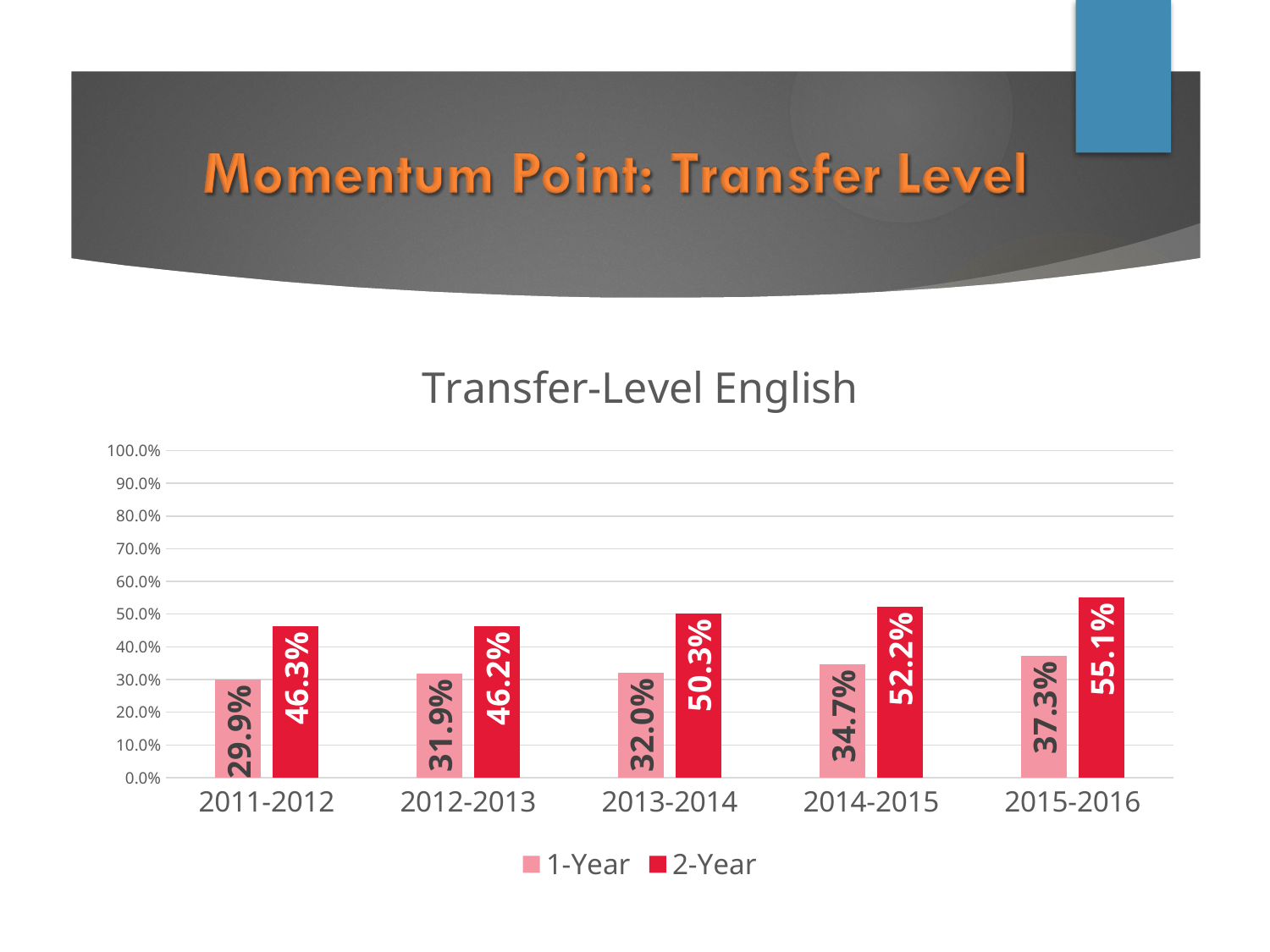
Which year has the highest 2-Year value? 2015-2016 What is the 2-Year value for 2013-2014? 50.3% What is the 1-Year value for 2011-2012? 29.9% Do the 2-Year values rise or fall from 2011-2012 to 2015-2016? rise Is the 2-Year value for 2011-2012 greater or less than 50.0%? less How many series does the legend list? 2 What is the difference between the 2-Year and 1-Year values for 2014-2015? 17.5% How many academic years are shown on the x axis? 5 Which is larger, the 1-Year value for 2015-2016 or the 1-Year value for 2012-2013? 2015-2016 Which year has the lowest 1-Year value? 2011-2012 What is the 2-Year value for 2015-2016? 55.1% What kind of chart is shown? bar chart